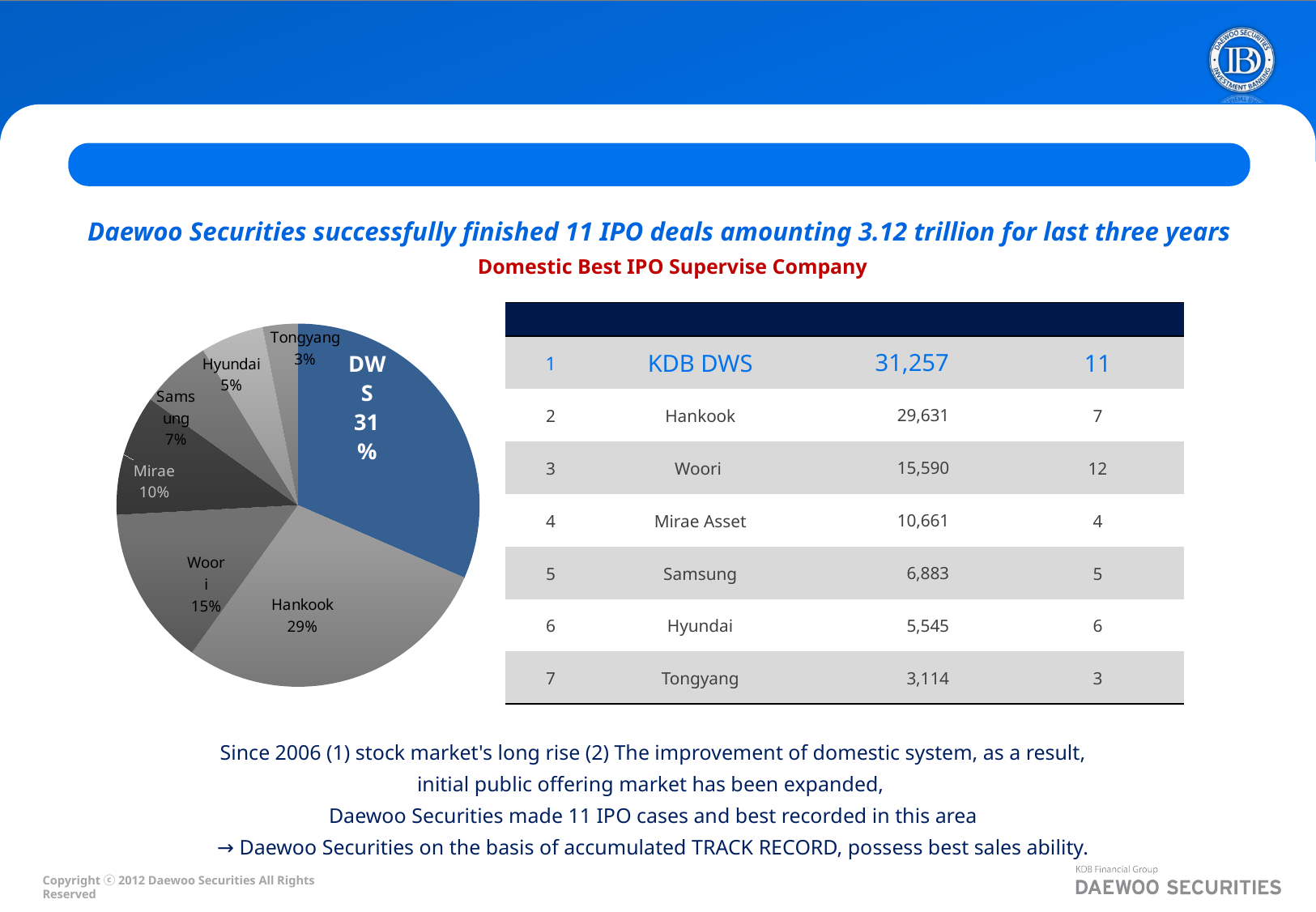
Which slice of the pie chart is the smallest? Tongyang In the pie chart, what is the difference in percentage points between Hyundai and Tongyang? 2 What kind of chart is shown on the left of the slide? pie chart How many slices does the pie chart have? 7 Which slice of the pie chart is the largest? DWS In the pie chart, which is larger: Woori or Mirae? Woori In the pie chart, what is the difference in percentage points between DWS and Hankook? 2 What is the value shown for Samsung in the pie chart? 7% What is the value shown for Mirae in the pie chart? 10% What is the value shown for Woori in the pie chart? 15% What share of the pie chart does DWS hold? 31% What share of the pie chart does Hankook hold? 29%